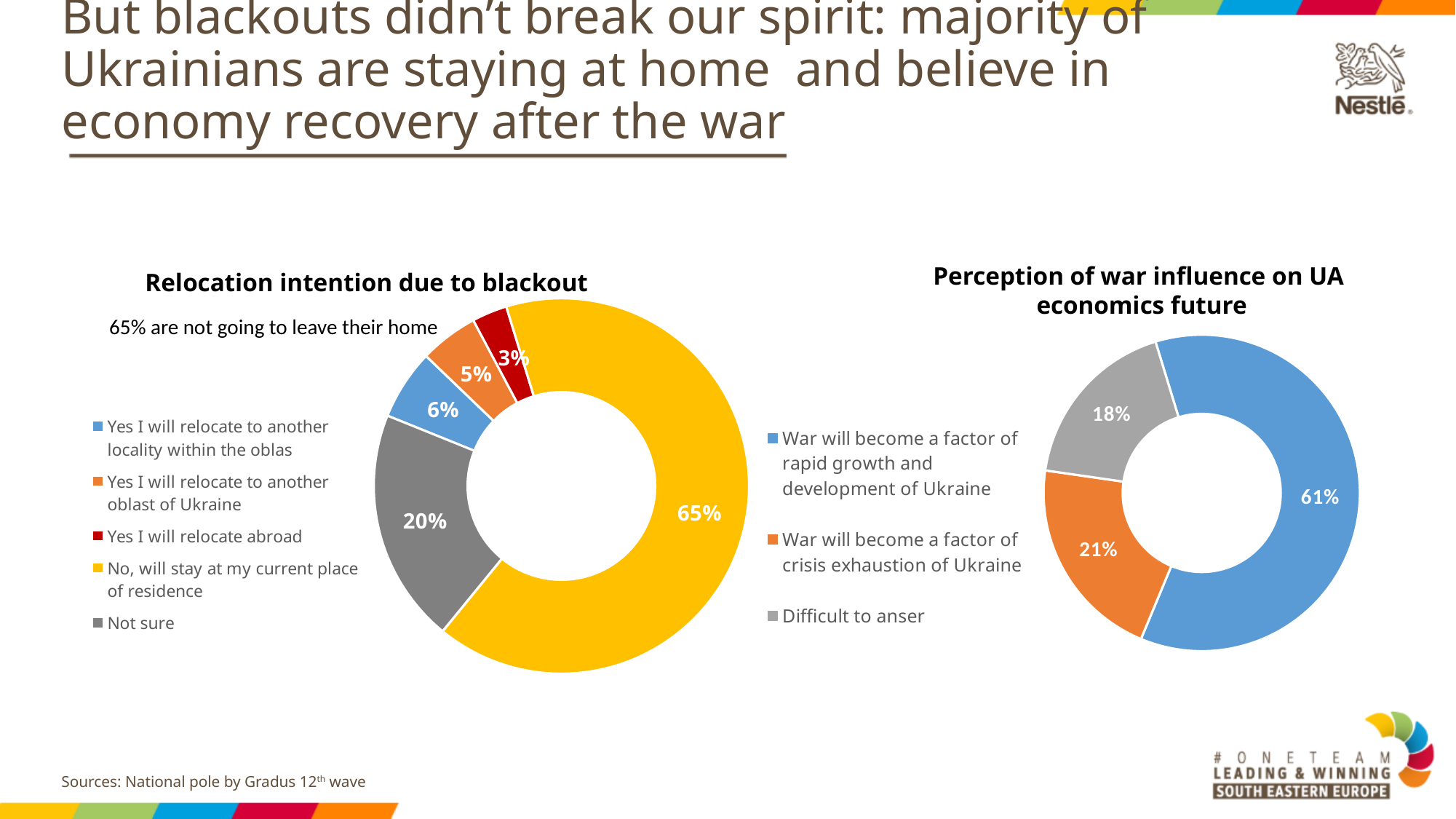
In the 'Relocation intention due to blackout' chart, which category has the smallest share? Yes I will relocate abroad In the 'Relocation intention due to blackout' chart, what is the difference between 'Not sure' and 'Yes I will relocate to another locality within the oblas'? 14% In the 'Perception of war influence on UA economics future' chart, which is larger: 'War will become a factor of crisis exhaustion of Ukraine' or 'Difficult to anser'? War will become a factor of crisis exhaustion of Ukraine What type of chart is used for 'Relocation intention due to blackout'? Doughnut (pie) chart In the 'Perception of war influence on UA economics future' chart, what share said 'War will become a factor of rapid growth and development of Ukraine'? 61% In the 'Relocation intention due to blackout' chart, what percentage answered 'Not sure'? 20% In the 'Perception of war influence on UA economics future' chart, what percentage answered 'Difficult to anser'? 18% In the 'Relocation intention due to blackout' chart, how many categories does the legend list? 5 In the 'Perception of war influence on UA economics future' chart, what is the difference between the 61% and 21% slices? 40% In the 'Perception of war influence on UA economics future' chart, which category has the largest share? War will become a factor of rapid growth and development of Ukraine In the 'Relocation intention due to blackout' chart, what percentage said 'Yes I will relocate abroad'? 3% In the 'Relocation intention due to blackout' chart, what share of respondents said 'No, will stay at my current place of residence'? 65%